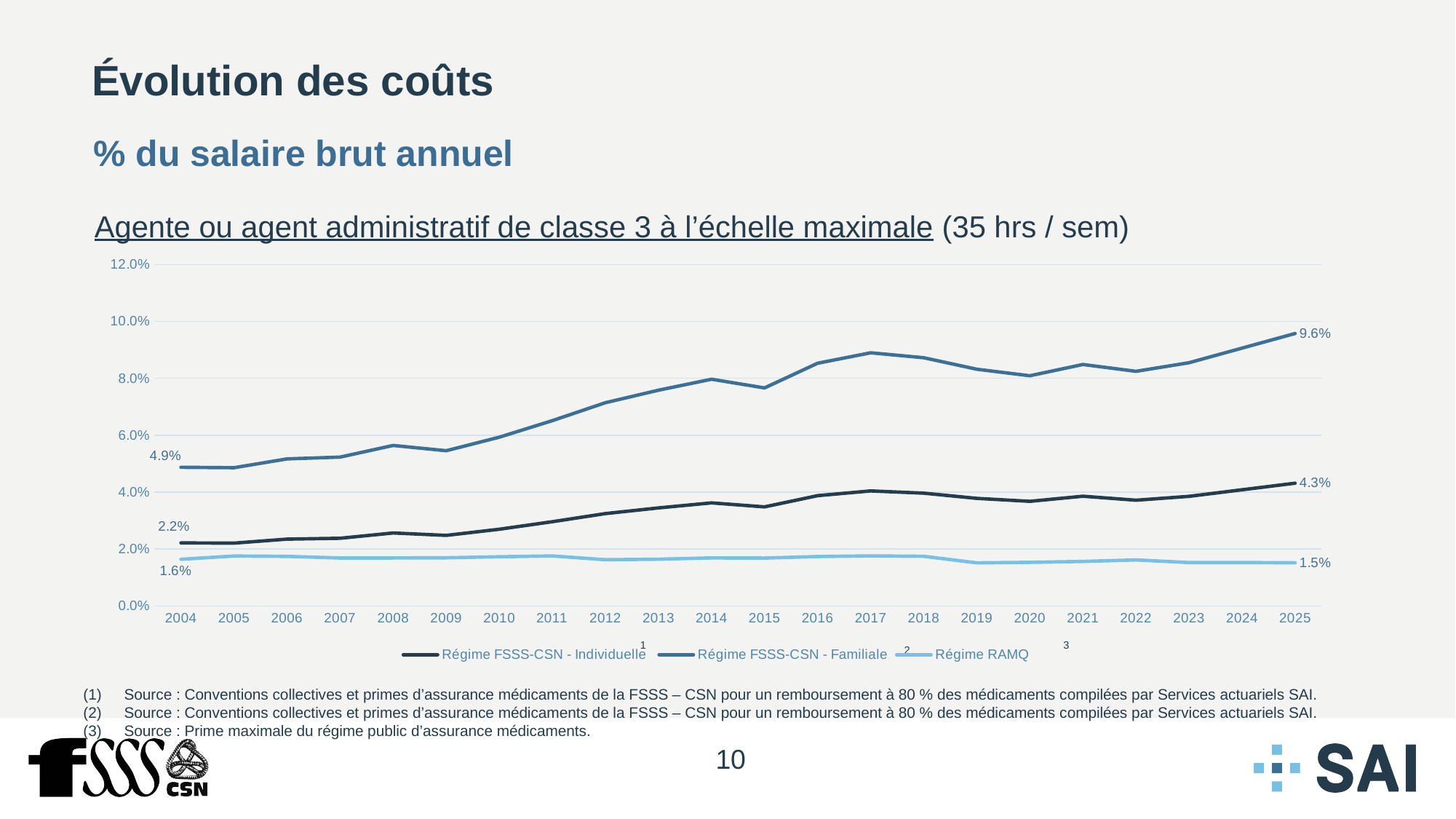
What is the difference between the Régime FSSS-CSN - Individuelle value and the Régime RAMQ value in 2025? 2.8% What is the difference between the Régime FSSS-CSN - Familiale values in 2025 and 2004? 4.7% What is the value for Régime RAMQ in 2025? 1.5% What type of chart is shown on the slide? line chart What is the value for Régime FSSS-CSN - Individuelle in 2004? 2.2% How many years are shown on the x axis? 22 Does the Régime FSSS-CSN - Individuelle series generally rise or fall from 2004 to 2025? rise Which series has the highest value in 2025? Régime FSSS-CSN - Familiale How many series does the legend list? 3 Is the value for Régime FSSS-CSN - Familiale in 2017 greater or less than 8.0%? greater What is the value for Régime FSSS-CSN - Familiale in 2004? 4.9% What is the value for Régime FSSS-CSN - Familiale in 2025? 9.6%